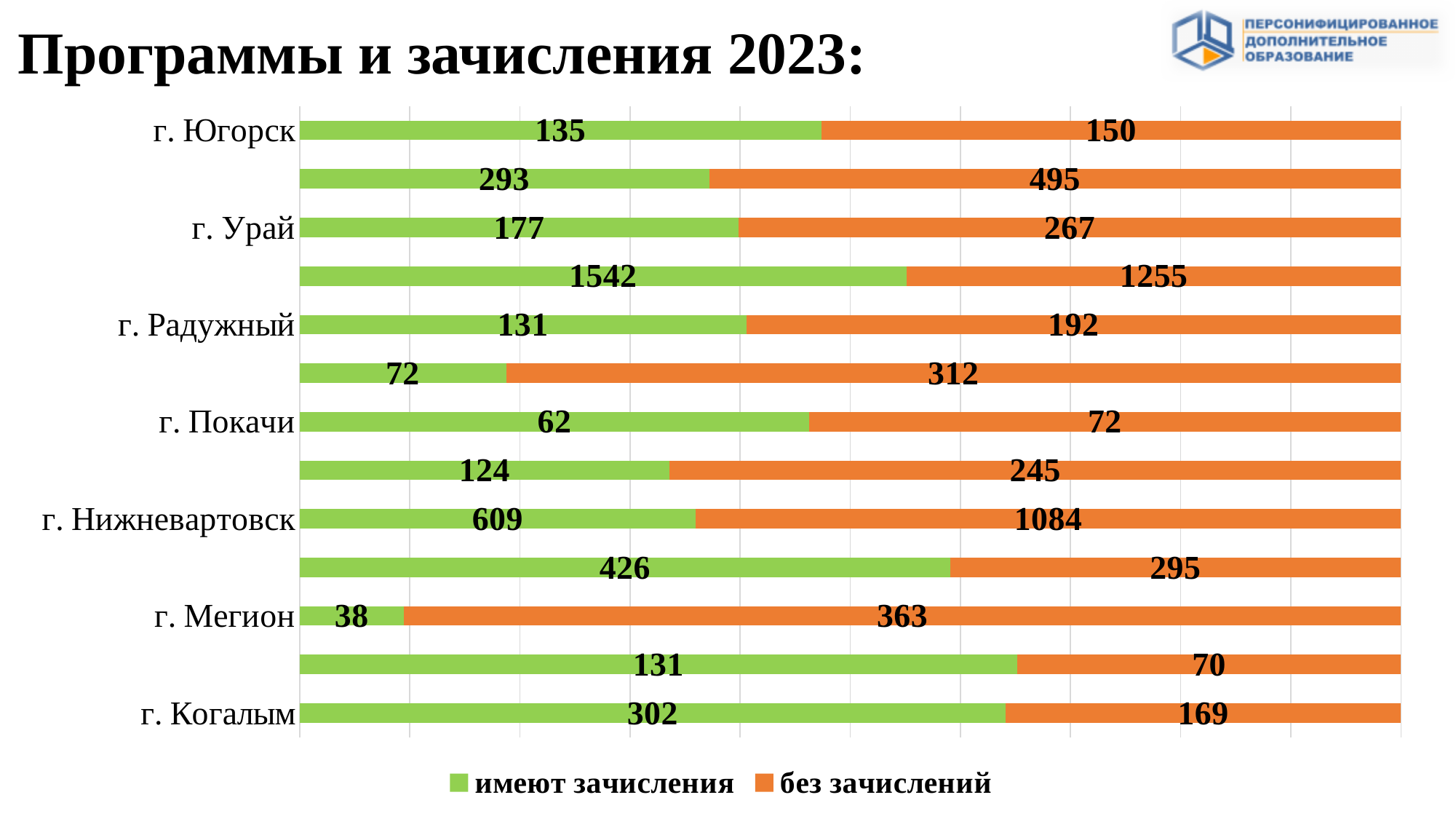
What kind of chart is shown on the slide? bar chart What is the value for "без зачислений" for г. Радужный? 192 What is the value for "имеют зачисления" for г. Мегион? 38 What is the total of the two values for г. Урай? 444 Which colour represents "без зачислений" in the chart? orange What is the difference between "без зачислений" and "имеют зачисления" for г. Мегион? 325 How many series does the legend list? 2 For г. Когалым, which is larger: "имеют зачисления" or "без зачислений"? имеют зачисления What is the difference between "без зачислений" and "имеют зачисления" for г. Нижневартовск? 475 What is the value for "без зачислений" for г. Нижневартовск? 1084 What is the total of the two values for г. Покачи? 134 What is the value for "имеют зачисления" for г. Югорск? 135